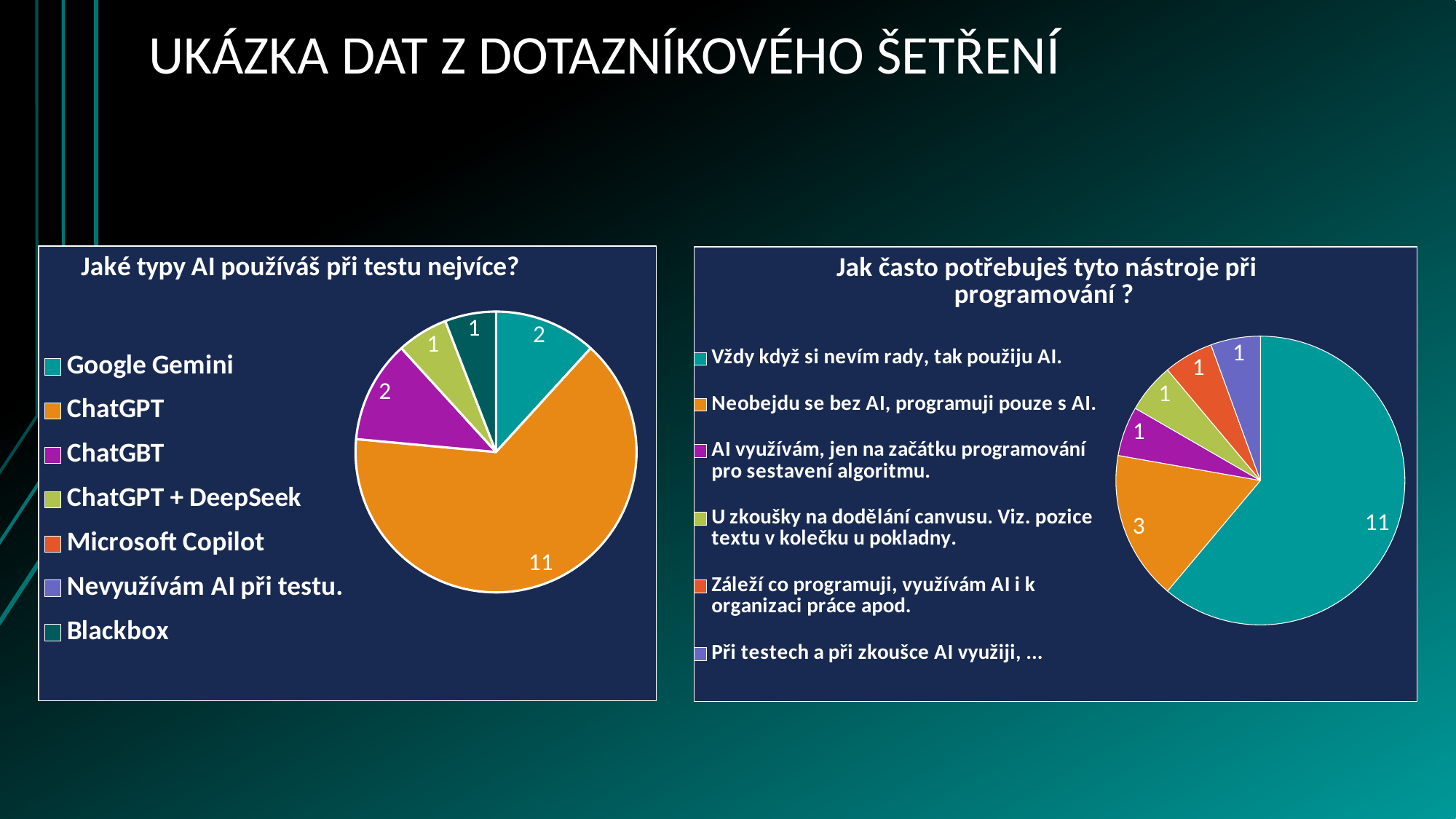
In the chart titled "Jak často potřebuješ tyto nástroje při programování ?", what value is shown for "Neobejdu se bez AI, programuji pouze s AI."? 3 In the chart titled "Jaké typy AI používáš při testu nejvíce?", what value is shown for ChatGPT? 11 In the chart titled "Jaké typy AI používáš při testu nejvíce?", what is the difference between the values for ChatGPT and ChatGBT? 9 How many slices does the pie in the chart titled "Jak často potřebuješ tyto nástroje při programování ?" have? 6 In the chart titled "Jaké typy AI používáš při testu nejvíce?", which category has the largest slice? ChatGPT In the chart titled "Jak často potřebuješ tyto nástroje při programování ?", what is the difference between the two largest slices? 8 What kind of chart is the chart titled "Jak často potřebuješ tyto nástroje při programování ?"? Pie chart In the chart titled "Jaké typy AI používáš při testu nejvíce?", what value is shown for Google Gemini? 2 How many entries does the legend of the chart titled "Jaké typy AI používáš při testu nejvíce?" list? 7 In the chart titled "Jaké typy AI používáš při testu nejvíce?", what colour is the ChatGPT slice? Orange In the chart titled "Jaké typy AI používáš při testu nejvíce?", which is larger, the value for Google Gemini or the value for Blackbox? Google Gemini In the chart titled "Jak často potřebuješ tyto nástroje při programování ?", what value is shown for "Vždy když si nevím rady, tak použiju AI."? 11